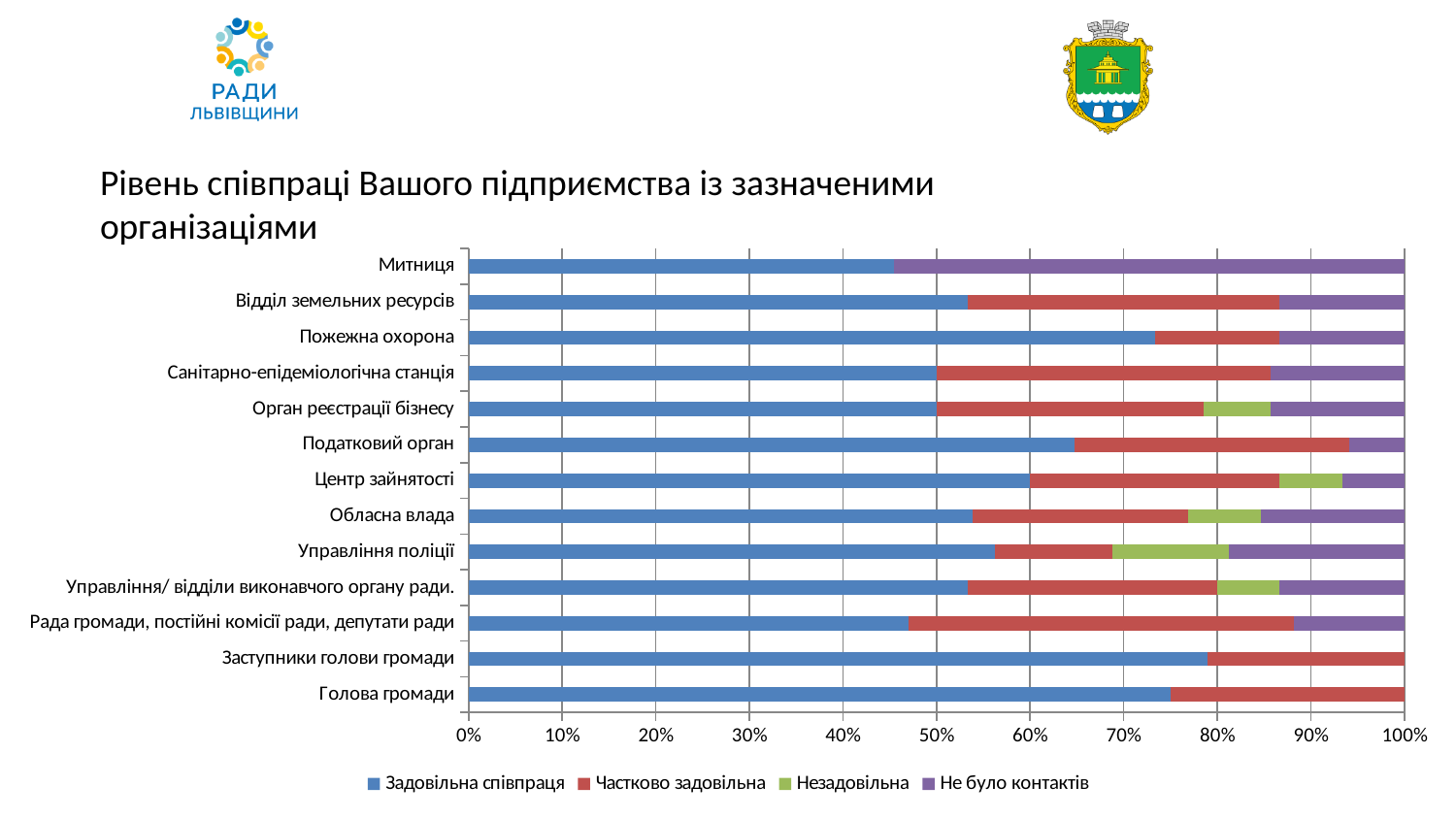
Is the 'Задовільна співпраця' share for Пожежна охорона greater or less than 70%? greater Which organisation has the largest 'Незадовільна' segment? Управління поліції Is the 'Задовільна співпраця' share for Рада громади, постійні комісії ради, депутати ради greater or less than 50%? less What is the title of the chart? Рівень співпраці Вашого підприємства із зазначеними організаціями Is the 'Задовільна співпраця' share for Податковий орган greater or less than 60%? greater Which legend entry is shown in purple? Не було контактів How many series does the chart legend list? 4 Which organisation has the largest 'Не було контактів' segment? Митниця How many organisations (categories) are listed on the vertical axis of the chart? 13 What kind of chart is shown on the slide? Stacked bar chart Which has the larger 'Задовільна співпраця' share: Митниця or Пожежна охорона? Пожежна охорона